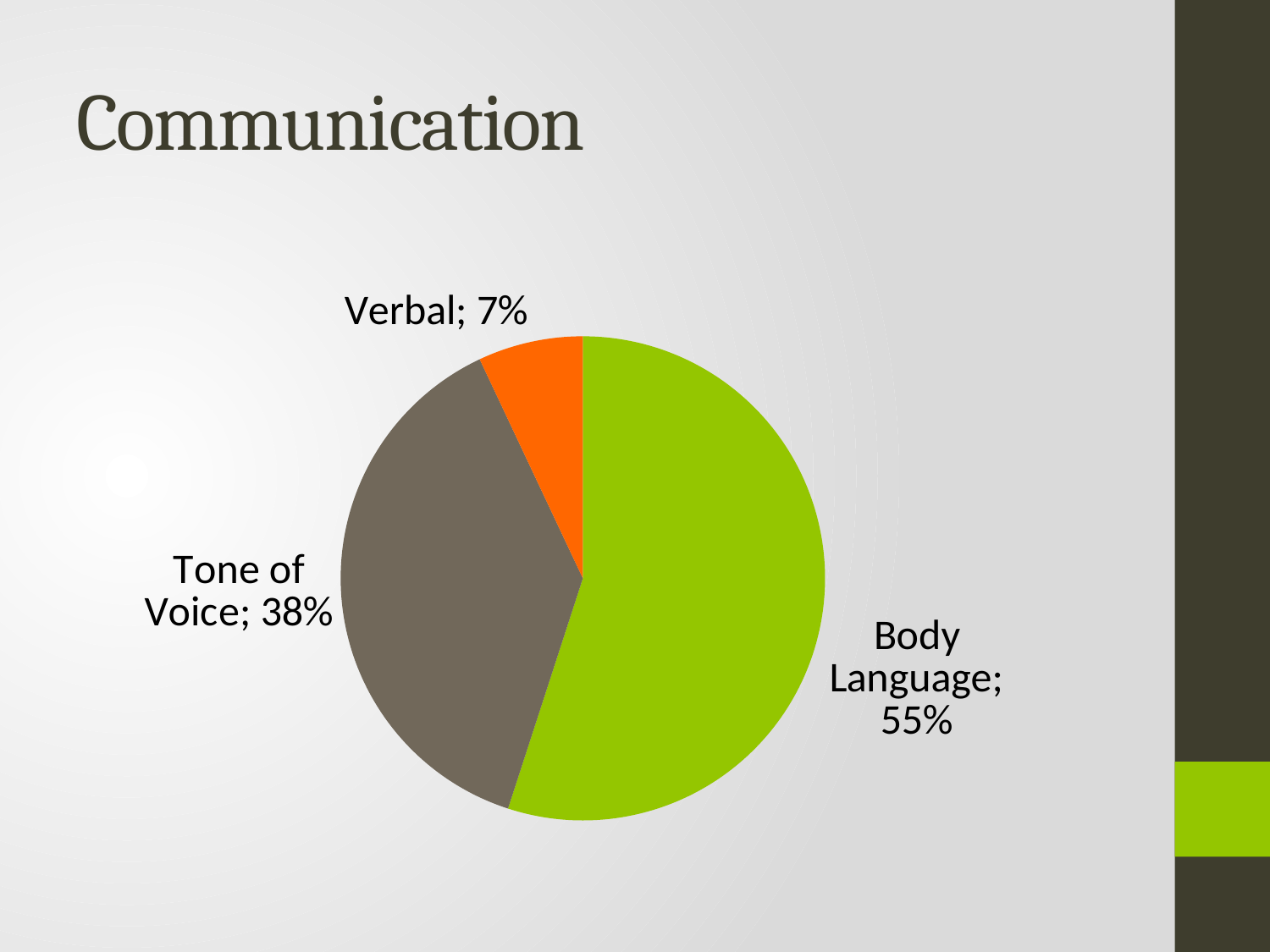
How many slices does the pie chart have? 3 What colour is the Verbal slice? Orange What is the difference between the Tone of Voice and Verbal percentages? 31% What percentage is shown for Tone of Voice? 38% Which category has the largest share of the pie? Body Language What is the title of the slide containing the pie chart? Communication What percentage is shown for Body Language? 55% Which category has the smallest share of the pie? Verbal What kind of chart is shown on the slide? Pie chart What percentage is shown for Verbal? 7% What is the difference between the Body Language and Tone of Voice percentages? 17% Which is larger, Tone of Voice or Verbal? Tone of Voice